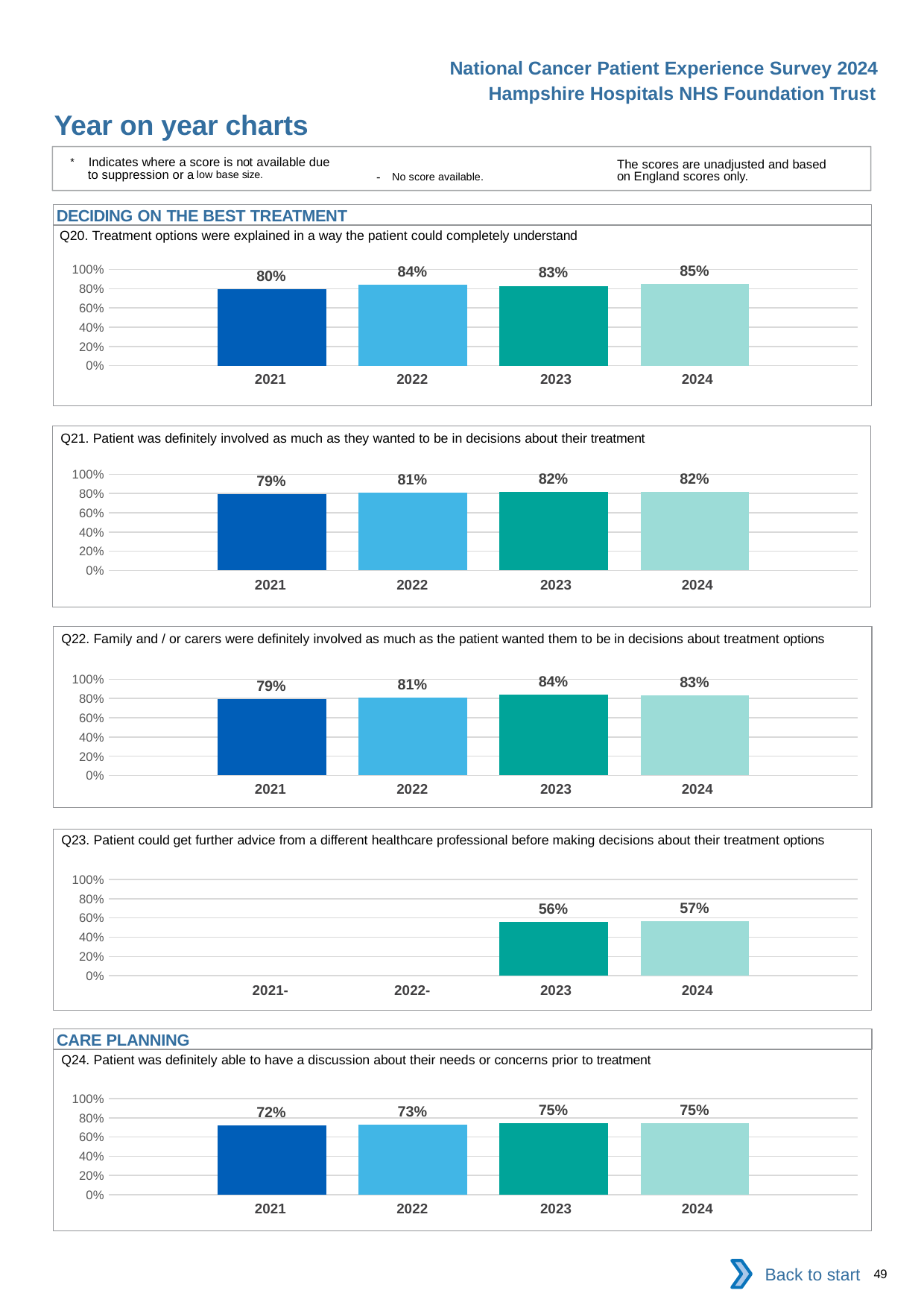
In the Q23 chart, what is the value for 2023? 56% What type of chart is the Q24 chart? Bar chart In the Q23 chart, how many years have a bar plotted? 2 In the Q23 chart, is the value for 2024 greater or less than 60%? less In the Q24 chart, what is the value for 2022? 73% In the Q21 chart, what is the difference between the 2024 value and the 2021 value? 3 percentage points In the Q22 chart, is the value for 2023 larger than the value for 2022? Yes, 2023 (84%) is larger than 2022 (81%) In the Q21 chart, what is the value for 2021? 79% In the Q22 chart, which year has the highest value? 2023 In the Q24 chart, do the values generally rise or fall from 2021 to 2024? Rise In the Q20 chart, what is the value for 2024? 85% In the Q20 chart, which year has the lowest value? 2021